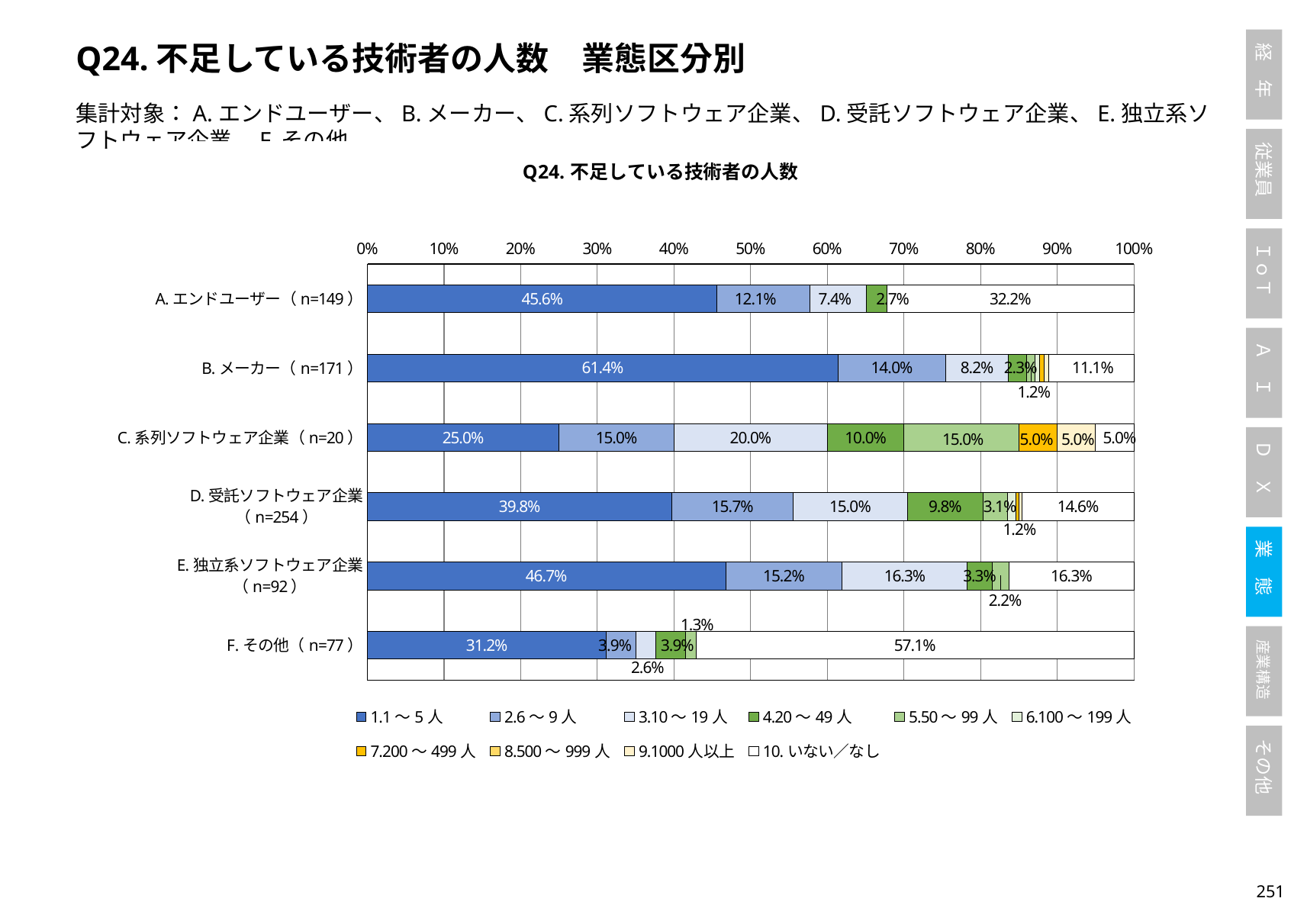
How many business-type categories are plotted on the chart? 6 What is the difference between the 1.1～5人 values for B. メーカー and A. エンドユーザー? 15.8% What is the title of the chart? Q24. 不足している技術者の人数 What is the value of the 3.10～19人 segment for C. 系列ソフトウェア企業 (n=20)? 20.0% Which category has the highest value for the 1.1～5人 segment? B. メーカー (n=171) What is the value of the 10. いない／なし segment for F. その他 (n=77)? 57.1% Which is larger: the 10. いない／なし value for A. エンドユーザー or for E. 独立系ソフトウェア企業? A. エンドユーザー What is the value of the 1.1～5人 segment for B. メーカー (n=171)? 61.4% Which category has the lowest value for the 1.1～5人 segment? C. 系列ソフトウェア企業 (n=20) What is the value of the 2.6～9人 segment for D. 受託ソフトウェア企業 (n=254)? 15.7% How many series does the legend list? 10 What kind of chart is shown on the slide? Stacked bar chart